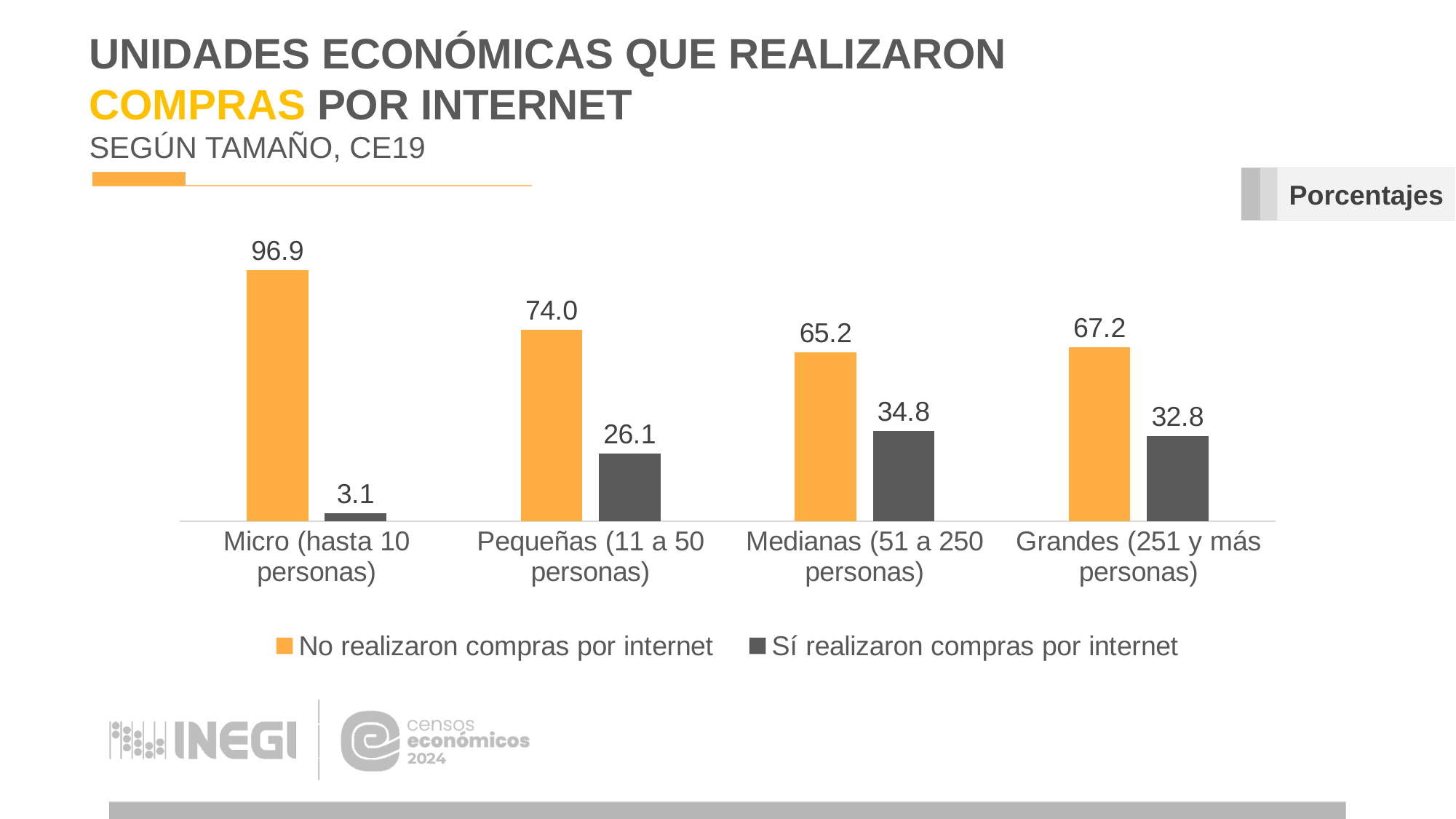
How many size categories are shown on the x axis? 4 Which is larger: the 'Sí realizaron compras por internet' value for Medianas (51 a 250 personas) or for Grandes (251 y más personas)? Medianas (51 a 250 personas) Which colour represents 'Sí realizaron compras por internet' in the legend? Dark grey Which size category has the highest value for 'No realizaron compras por internet'? Micro (hasta 10 personas) What is the difference between the 'No realizaron' and 'Sí realizaron' values for Pequeñas (11 a 50 personas)? 47.9 What is the value for 'No realizaron compras por internet' for Grandes (251 y más personas)? 67.2 What is the value for 'No realizaron compras por internet' for Pequeñas (11 a 50 personas)? 74.0 How many series does the legend list? 2 What is the value for 'Sí realizaron compras por internet' for Micro (hasta 10 personas)? 3.1 Which size category has the lowest value for 'Sí realizaron compras por internet'? Micro (hasta 10 personas) What is the value for 'Sí realizaron compras por internet' for Medianas (51 a 250 personas)? 34.8 What kind of chart is shown on the slide? Bar chart